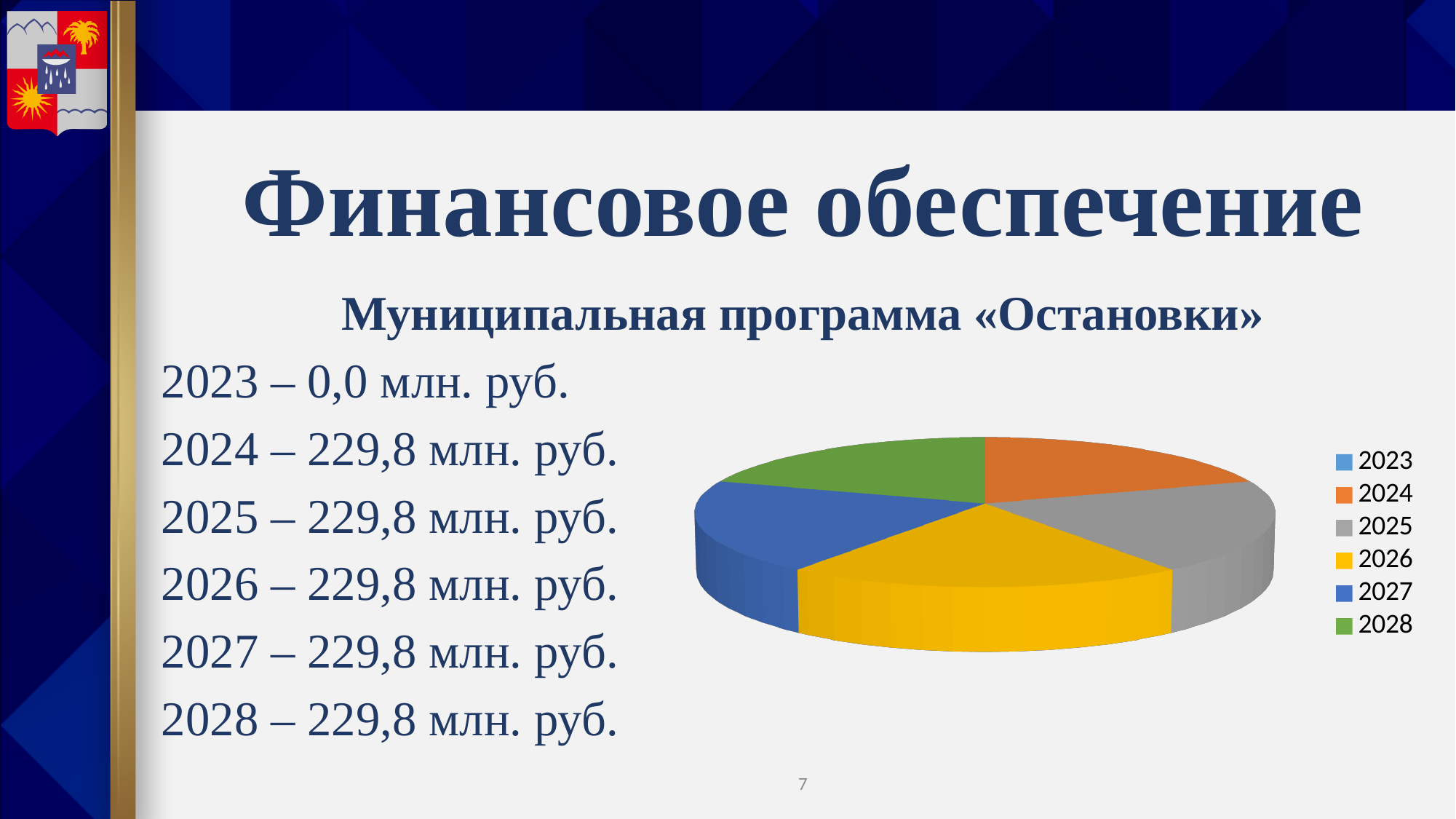
According to the slide, what is the funding amount for 2024? 229,8 млн. руб. How many entries does the chart legend list? 6 According to the slide, what is the funding amount for 2023? 0,0 млн. руб. What is the difference between the funding for 2028 and the funding for 2023? 229,8 млн. руб. What colour is the slice for 2026 in the pie chart? yellow Which is larger, the funding for 2024 or for 2023? 2024 Which years are listed in the chart legend? 2023, 2024, 2025, 2026, 2027, 2028 How many slices are visible in the pie chart? 5 What kind of chart is shown on the slide? pie chart Which year has the lowest funding amount? 2023 What share of the pie does the 2025 slice represent? 20% Do the funding amounts rise, fall or stay the same from 2024 to 2028? stay the same